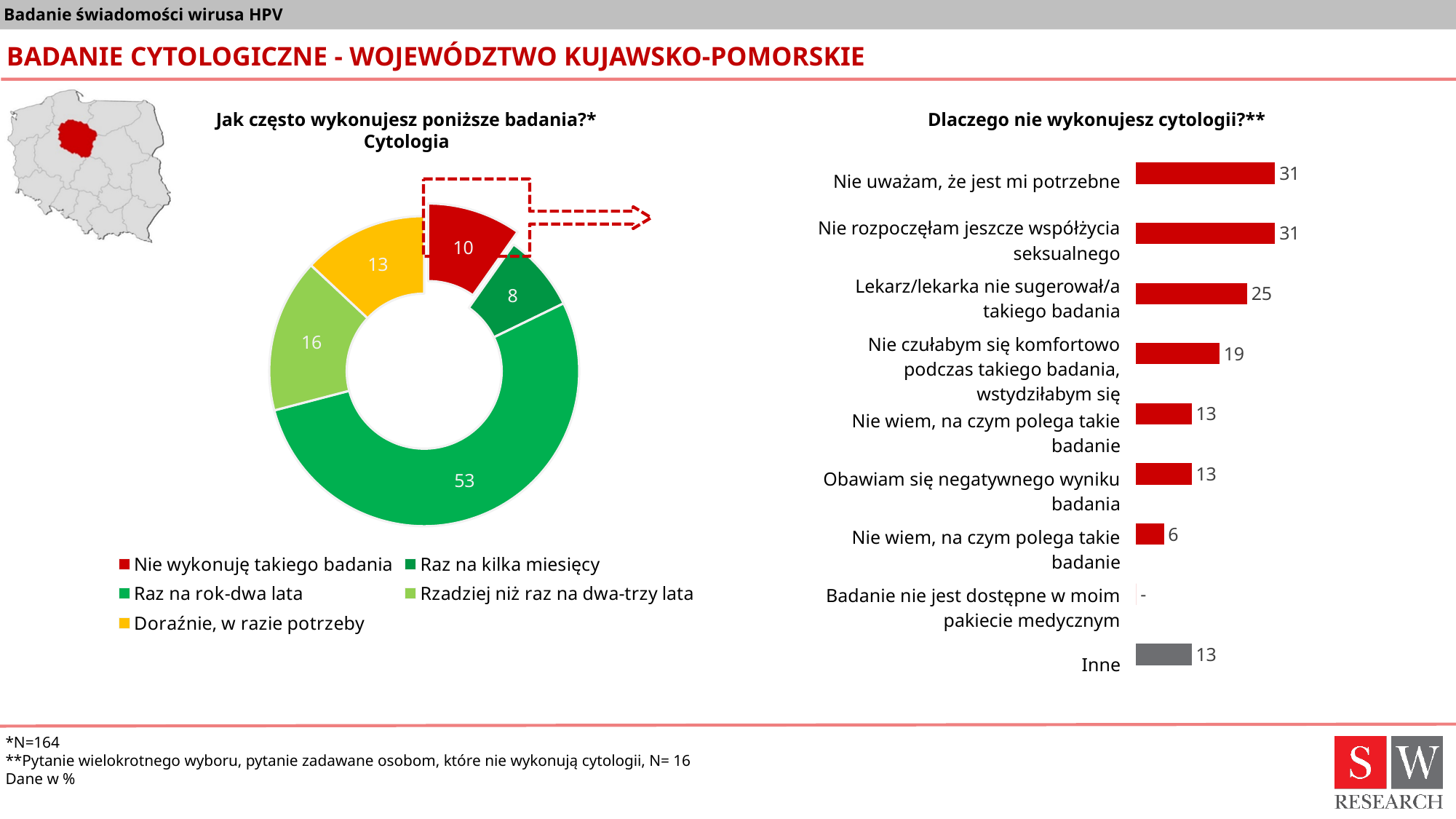
In the bar chart 'Dlaczego nie wykonujesz cytologii?', what is the difference between 'Nie rozpoczęłam jeszcze współżycia seksualnego' and 'Lekarz/lekarka nie sugerował/a takiego badania'? 6 In the bar chart 'Dlaczego nie wykonujesz cytologii?', what is the value for 'Inne'? 13 In the bar chart 'Dlaczego nie wykonujesz cytologii?', what is the value for 'Nie czułabym się komfortowo podczas takiego badania, wstydziłabym się'? 19 In the donut chart 'Jak często wykonujesz poniższe badania? Cytologia', what is the difference between 'Rzadziej niż raz na dwa-trzy lata' and 'Doraźnie, w razie potrzeby'? 3 How many categories does the legend of the donut chart 'Jak często wykonujesz poniższe badania? Cytologia' list? 5 In the donut chart 'Jak często wykonujesz poniższe badania? Cytologia', which category has the largest value? Raz na rok-dwa lata In the donut chart 'Jak często wykonujesz poniższe badania? Cytologia', what is the value for 'Nie wykonuję takiego badania'? 10 In the bar chart 'Dlaczego nie wykonujesz cytologii?', which is larger: 'Nie uważam, że jest mi potrzebne' or 'Obawiam się negatywnego wyniku badania'? Nie uważam, że jest mi potrzebne In the bar chart 'Dlaczego nie wykonujesz cytologii?', what is the value for 'Lekarz/lekarka nie sugerował/a takiego badania'? 25 In the donut chart 'Jak często wykonujesz poniższe badania? Cytologia', which category has the smallest value? Raz na kilka miesięcy What type of chart is 'Dlaczego nie wykonujesz cytologii?'? Bar chart In the donut chart 'Jak często wykonujesz poniższe badania? Cytologia', what is the value for 'Raz na rok-dwa lata'? 53